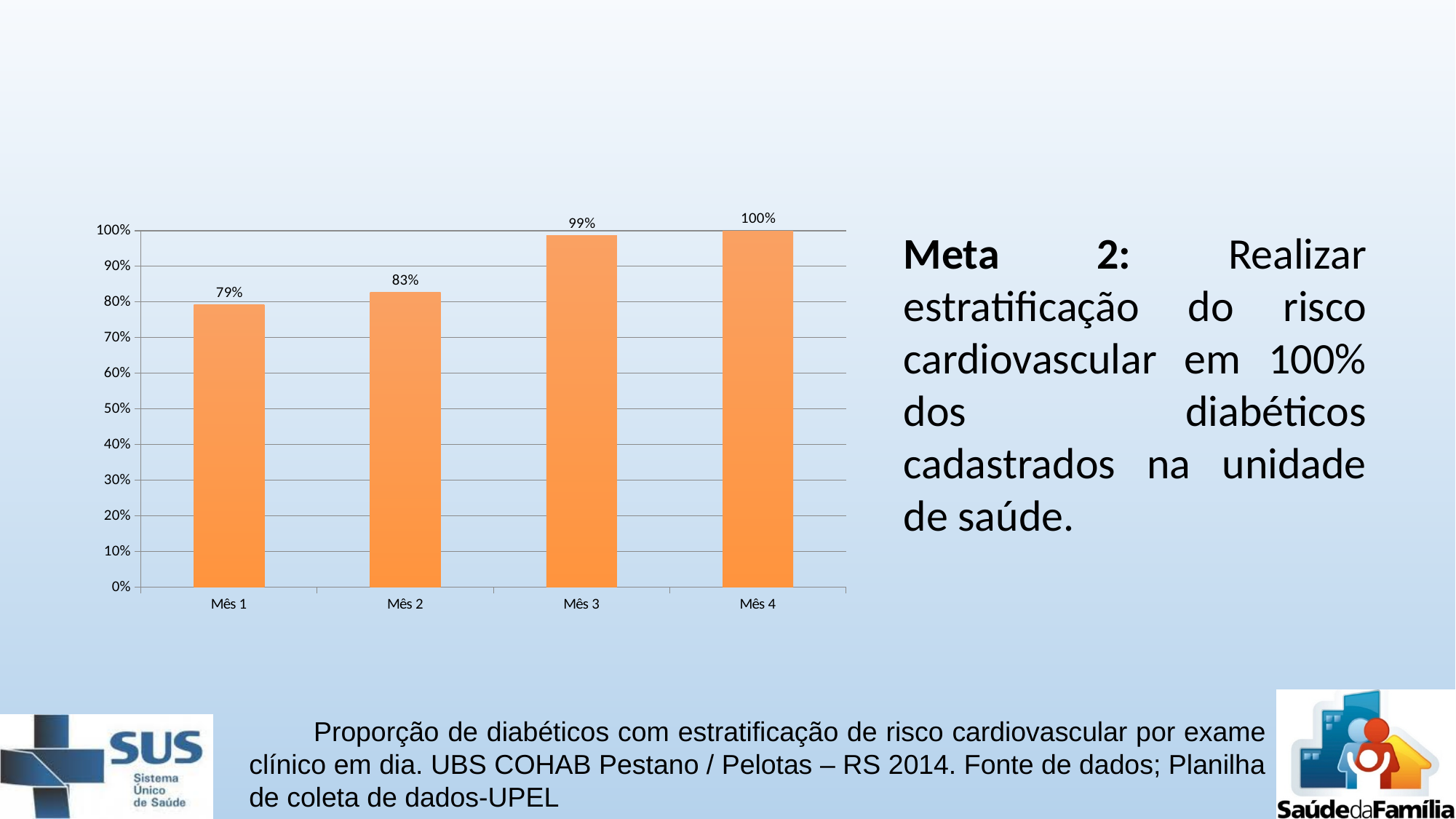
Which month has the lowest value? Mês 1 How many months are shown on the x axis? 4 What kind of chart is shown on the slide? Bar chart Which is larger, the value for Mês 2 or the value for Mês 3? Mês 3 What is the value for Mês 2? 83% What is the value for Mês 3? 99% Do the values rise or fall from Mês 1 to Mês 4? Rise What is the value for Mês 1? 79% What is the value for Mês 4? 100% What is the difference between the values for Mês 2 and Mês 1? 4% What is the difference between the values for Mês 3 and Mês 1? 20% Which month has the highest value? Mês 4